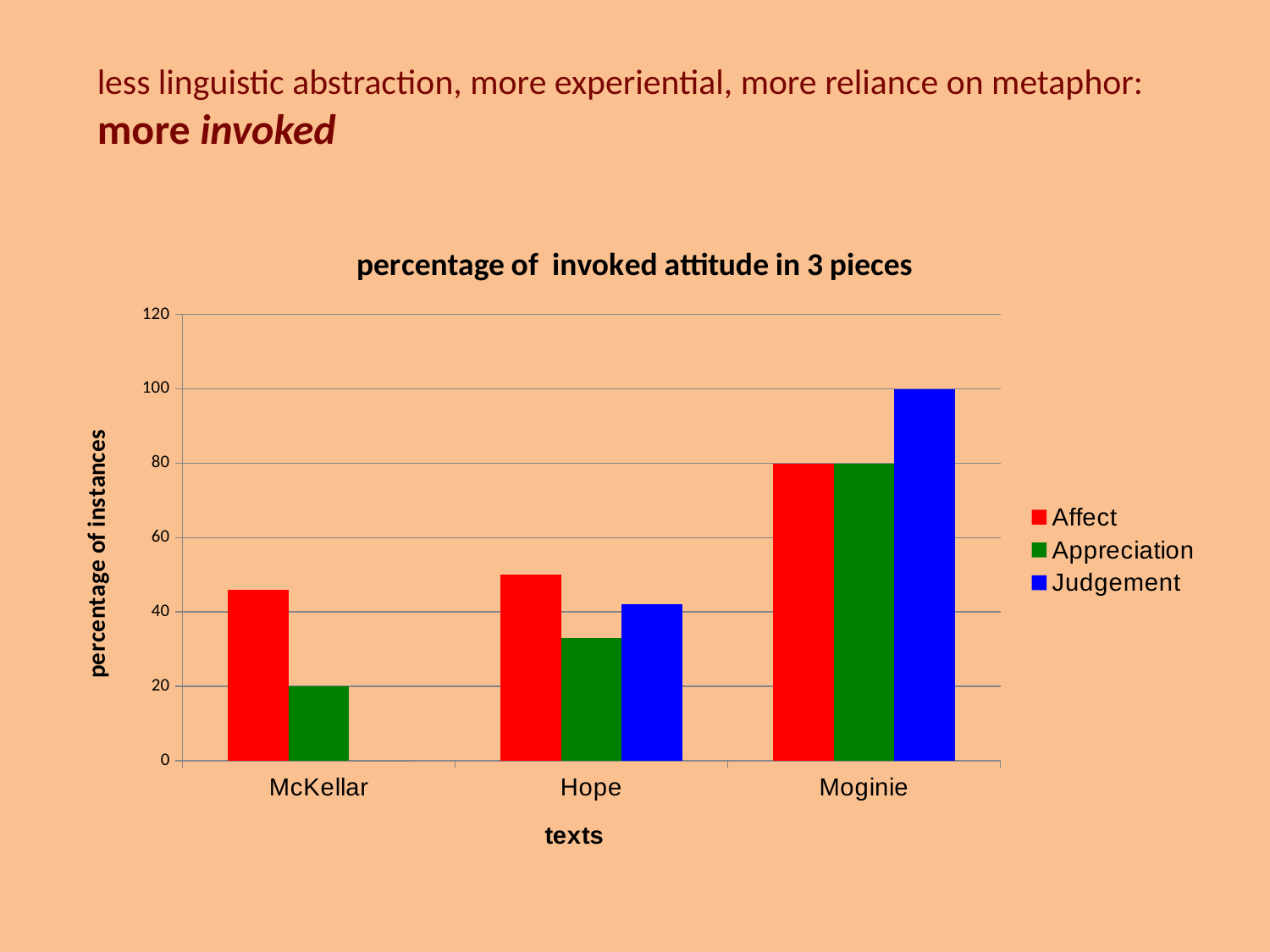
What is the title of the chart? percentage of invoked attitude in 3 pieces What is the Affect value for Moginie? 80 Which text has the highest Judgement value? Moginie What is the difference between the Judgement and Affect values for Moginie? 20 How many texts are shown on the x axis? 3 What kind of chart is shown on the slide? bar chart Is the Affect value for Hope greater or less than 40? greater Which text has the lowest Affect value? McKellar What is the Judgement value for Moginie? 100 Does the Affect value rise or fall from McKellar to Moginie? rise What is the Appreciation value for McKellar? 20 How many series does the legend list? 3